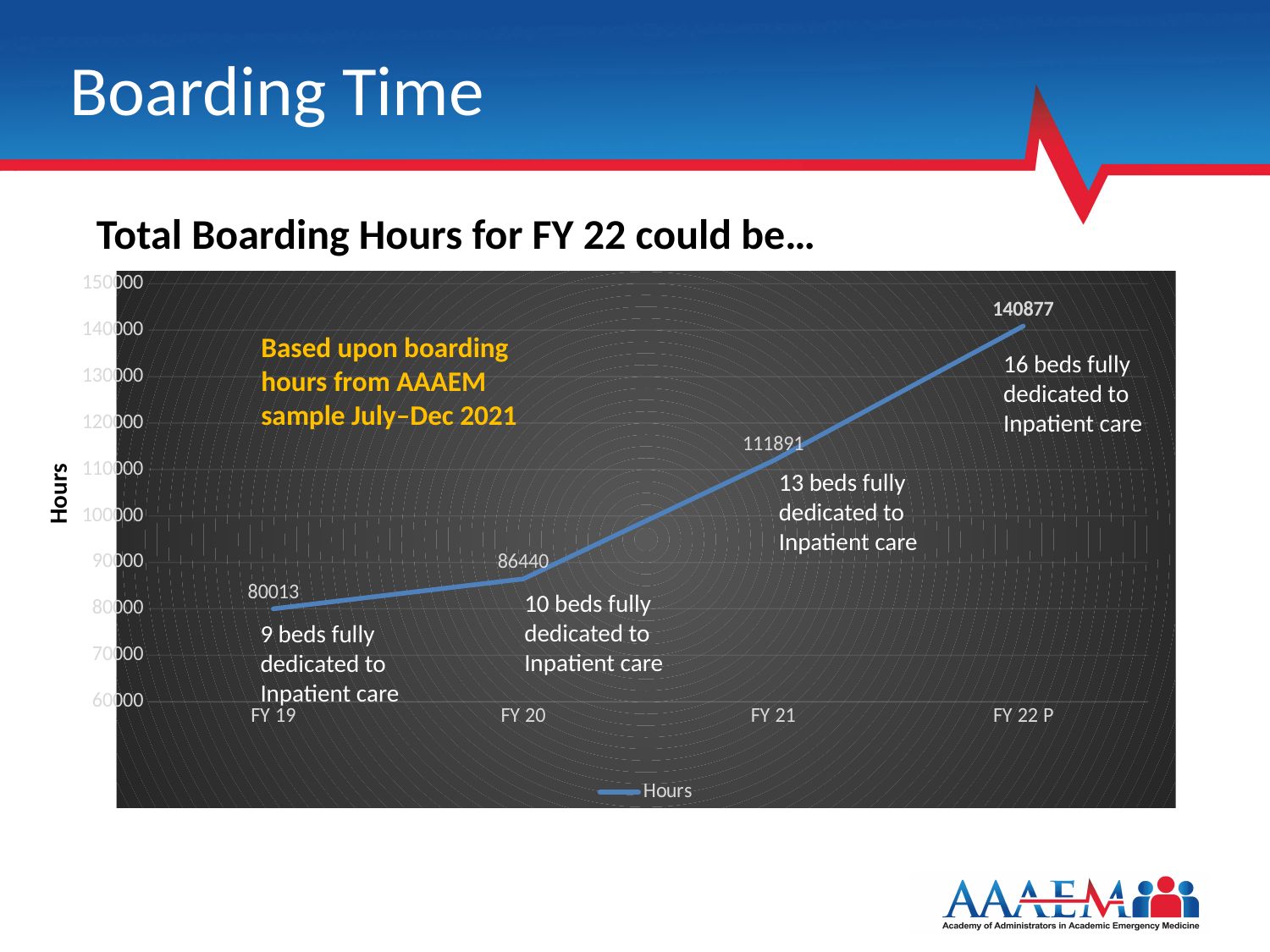
What is the value for FY 19? 80013 What is the difference in hours between FY 22 P and FY 21? 28986 What is the value for FY 20? 86440 Which fiscal year has the lowest number of hours? FY 19 What is the value for FY 21? 111891 Which is larger, the value for FY 21 or the value for FY 20? FY 21 Which fiscal year has the highest number of hours? FY 22 P How many fiscal years are plotted on the chart? 4 Do the hours rise or fall from FY 19 to FY 22 P? Rise What kind of chart is shown? Line chart What is the difference in hours between FY 20 and FY 19? 6427 What is the value for FY 22 P? 140877